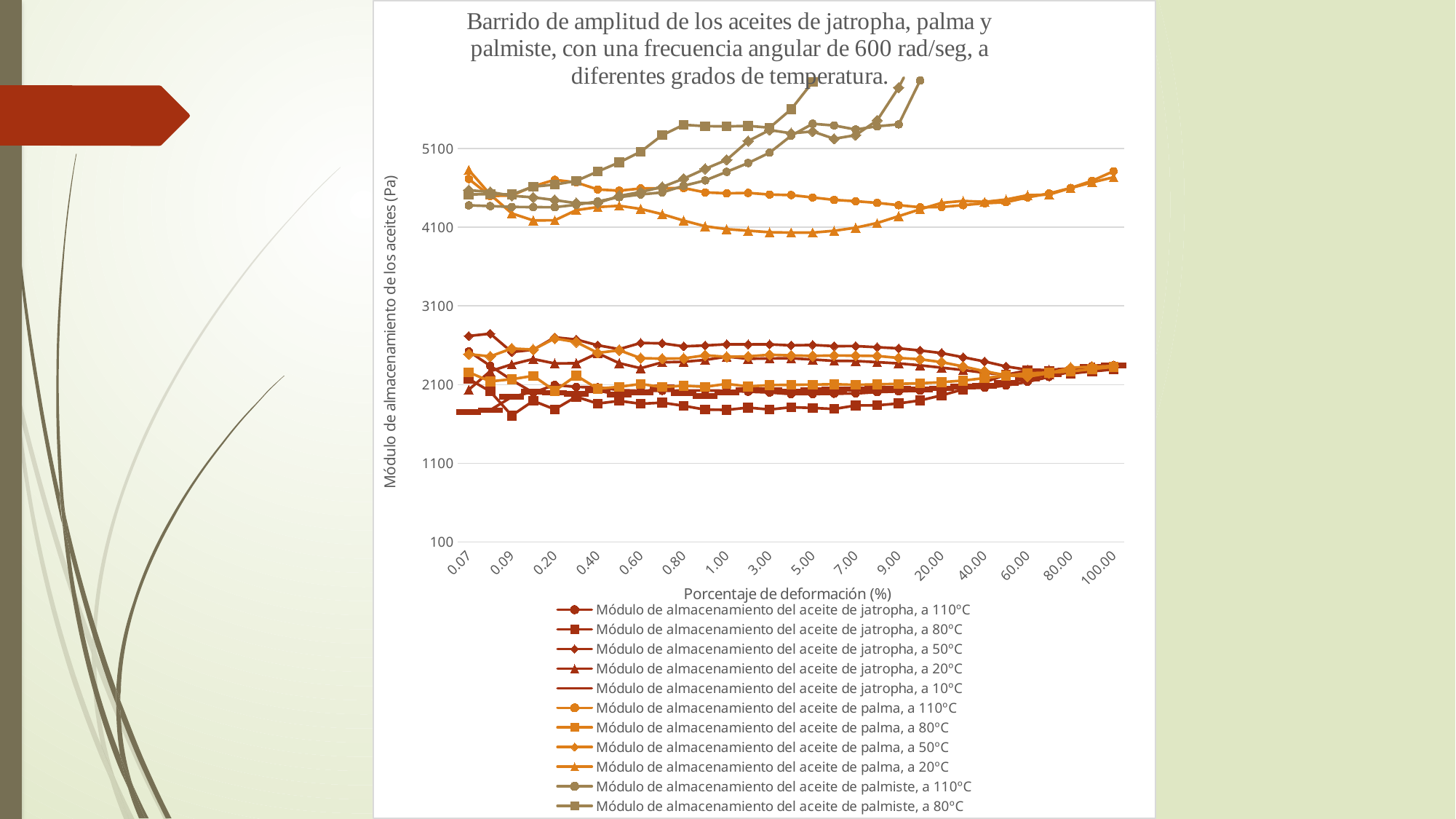
Is the value for 'Módulo de almacenamiento del aceite de palmiste, a 80°C' at 1.00% deformation greater or less than 5100? greater How many tick labels are shown along the x axis (Porcentaje de deformación)? 16 Is the value for 'Módulo de almacenamiento del aceite de palma, a 20°C' at 100.00% deformation greater or less than 4100? greater Is the value for 'Módulo de almacenamiento del aceite de palma, a 20°C' at 3.00% deformation greater or less than 4100? less What is the label of the x axis? Porcentaje de deformación (%) How many series does the legend list? 11 What is the label of the y axis? Módulo de almacenamiento de los aceites (Pa) What kind of chart is shown on the slide? line chart Does the series 'Módulo de almacenamiento del aceite de palmiste, a 80°C' rise or fall as the deformation percentage increases along the x axis? rise